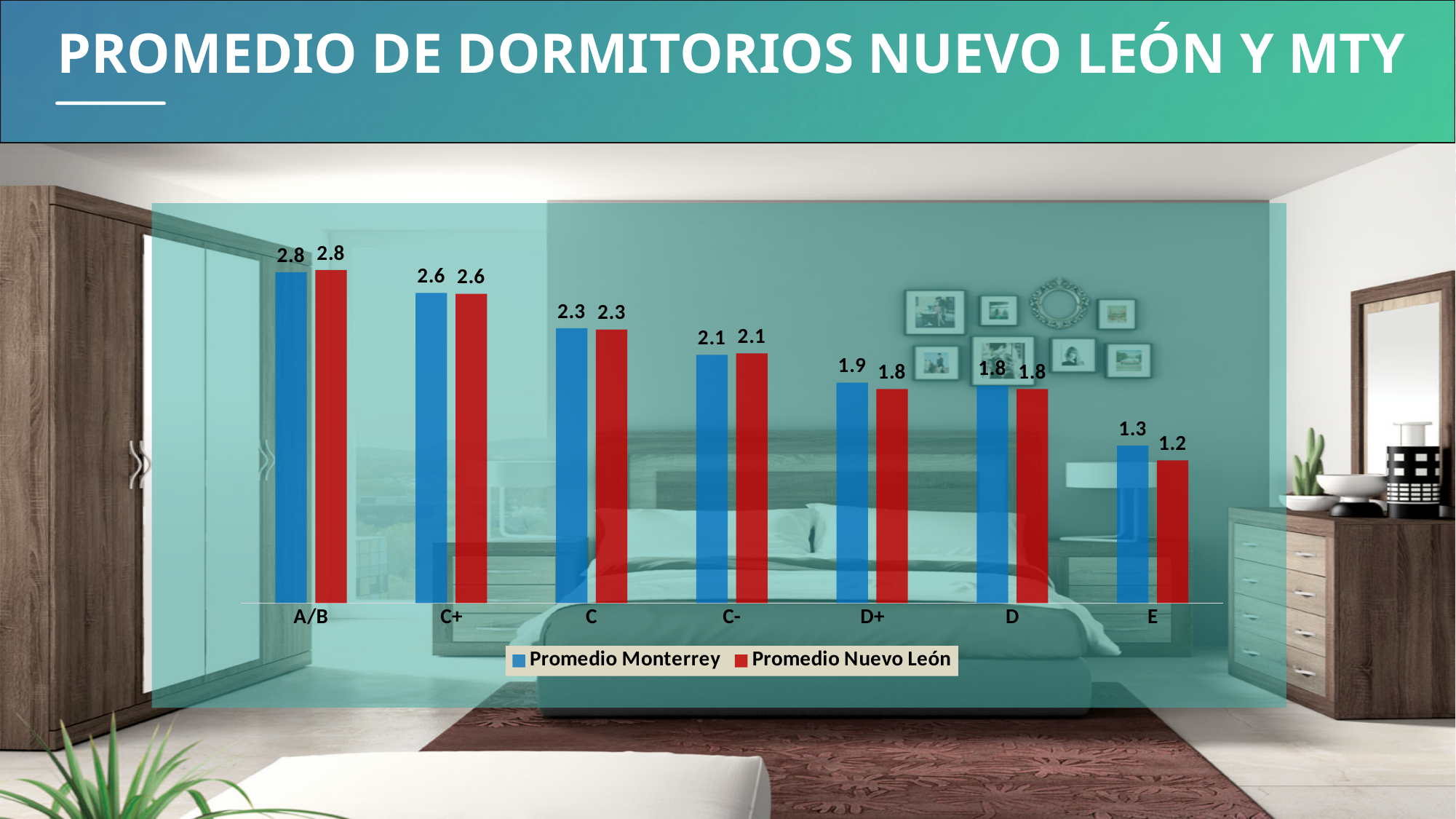
What kind of chart is shown on the slide? Bar chart What is the Promedio Nuevo León value for category C-? 2.1 Which category has the lowest Promedio Nuevo León value? E Do the Promedio Nuevo León values rise or fall from A/B to E? Fall What is the Promedio Monterrey value for category D+? 1.9 How many series does the legend list? 2 For category D+, which is larger: Promedio Monterrey or Promedio Nuevo León? Promedio Monterrey What is the difference between the Promedio Monterrey values for A/B and E? 1.5 What is the Promedio Nuevo León value for category E? 1.2 What is the Promedio Monterrey value for category A/B? 2.8 Which category has the highest Promedio Monterrey value? A/B How many categories are shown on the x axis? 7